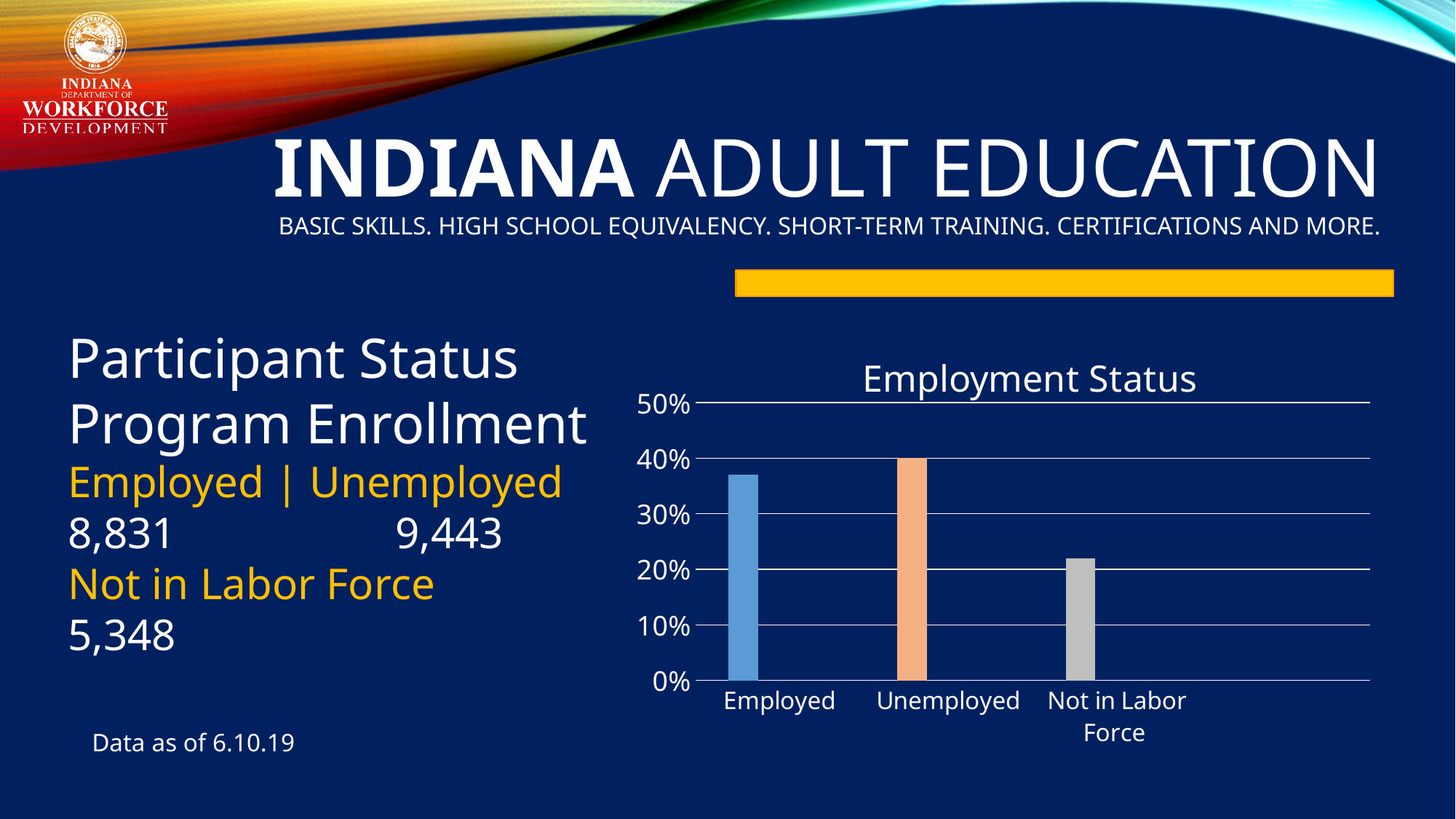
Which category has the lowest value in the Employment Status chart? Not in Labor Force What is the highest value shown on the y axis of the Employment Status chart? 50% Is the value for Not in Labor Force greater or less than 30%? less Is the value for Employed greater or less than 30%? greater Is the value for Not in Labor Force greater or less than 10%? greater Which is larger in the Employment Status chart, Employed or Not in Labor Force? Employed What type of chart is shown on the slide? bar chart Which category has the highest value in the Employment Status chart? Unemployed What is the title of the chart? Employment Status How many categories are shown on the x axis of the Employment Status chart? 3 What colour is the Unemployed bar in the Employment Status chart? orange